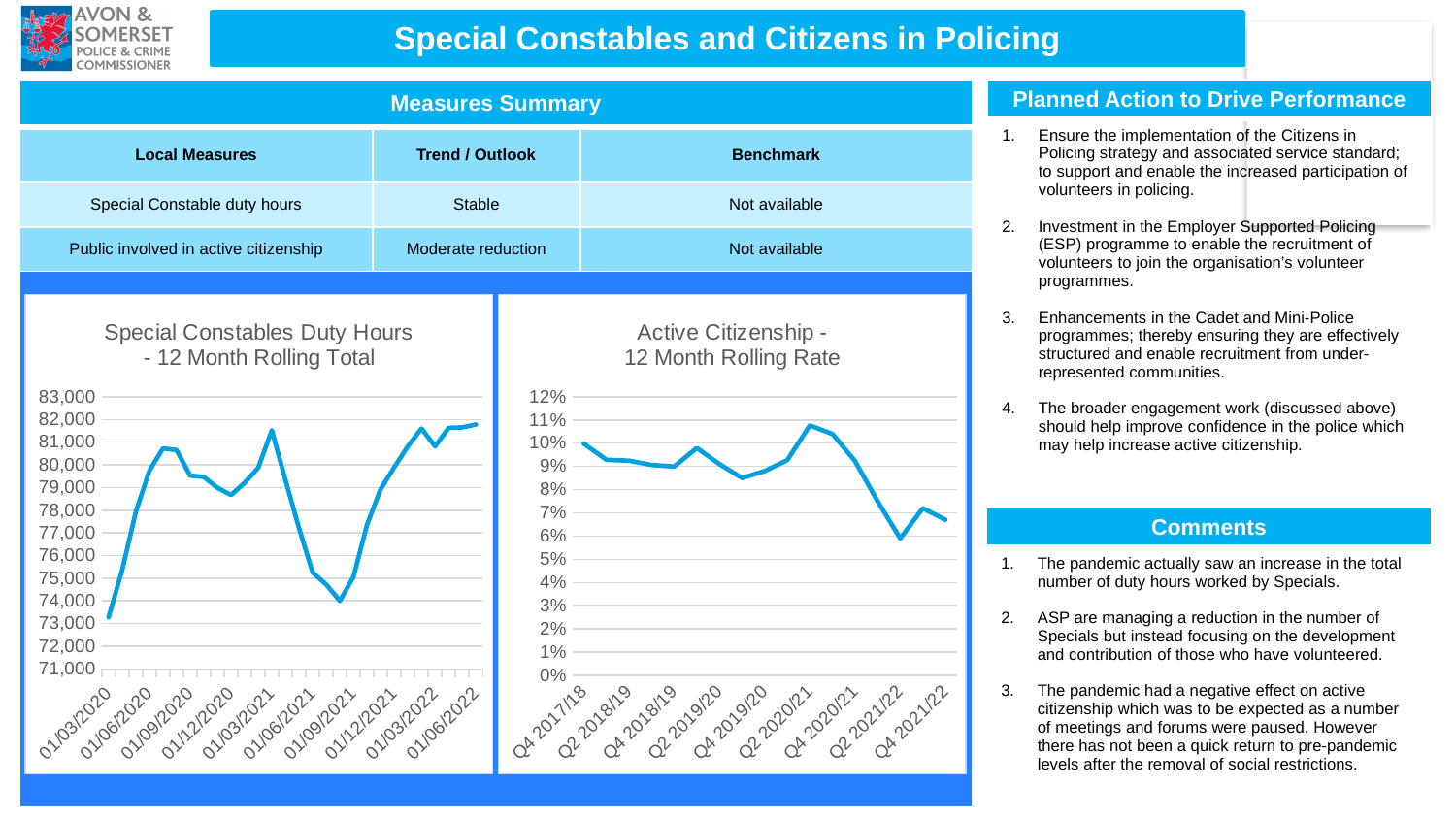
In the 'Active Citizenship - 12 Month Rolling Rate' chart, is the value at Q4 2021/22 greater or less than 8%? less In the 'Special Constables Duty Hours - 12 Month Rolling Total' chart, is the value at 01/03/2020 greater or less than 75,000? less What type of chart is the 'Special Constables Duty Hours - 12 Month Rolling Total' chart? Line chart In the 'Special Constables Duty Hours - 12 Month Rolling Total' chart, which is higher: the value at 01/06/2020 or the value at 01/12/2020? 01/06/2020 In the 'Active Citizenship - 12 Month Rolling Rate' chart, is the value at Q2 2020/21 greater or less than 10%? greater What type of chart is the 'Active Citizenship - 12 Month Rolling Rate' chart? Line chart In the 'Active Citizenship - 12 Month Rolling Rate' chart, which is higher: the value at Q4 2017/18 or the value at Q4 2021/22? Q4 2017/18 How many charts are shown on the slide? 2 What is the title of the chart on the right of the slide? Active Citizenship - 12 Month Rolling Rate In the 'Active Citizenship - 12 Month Rolling Rate' chart, does the rate overall rise or fall from Q4 2017/18 to Q4 2021/22? Fall